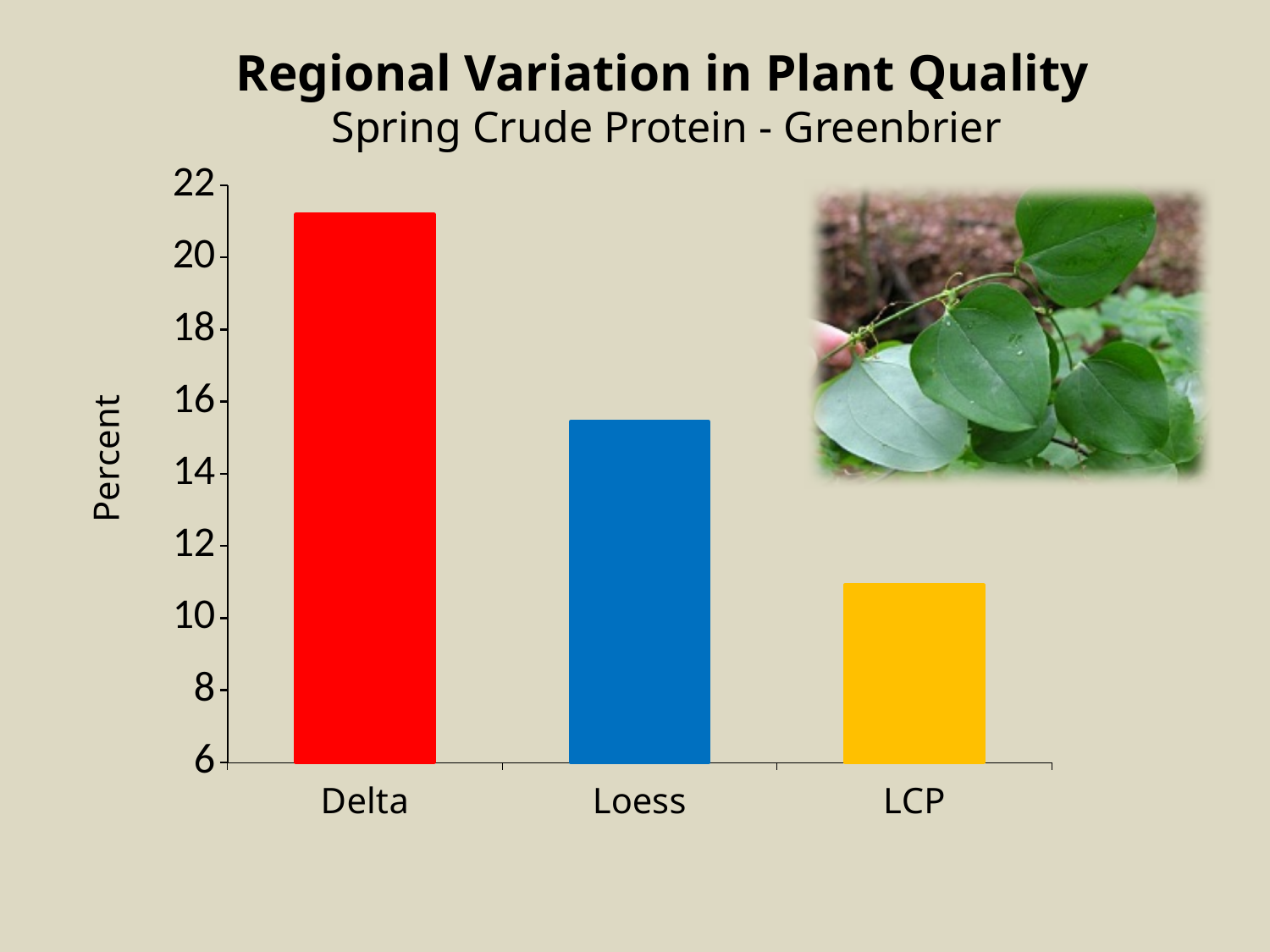
Which region has the lowest spring crude protein value for greenbrier? LCP Is the value for Loess greater or less than 16? less Is the value for LCP greater or less than 10? greater Do the values rise or fall moving from Delta to LCP along the x axis? fall Which has a higher value, Loess or LCP? Loess What is the label on the y axis of the chart? Percent Is the value for LCP greater or less than 12? less What kind of chart is shown on the slide? bar chart How many regions are shown on the x axis of the chart? 3 Which has a higher value, Delta or Loess? Delta Which region has the highest spring crude protein value for greenbrier? Delta